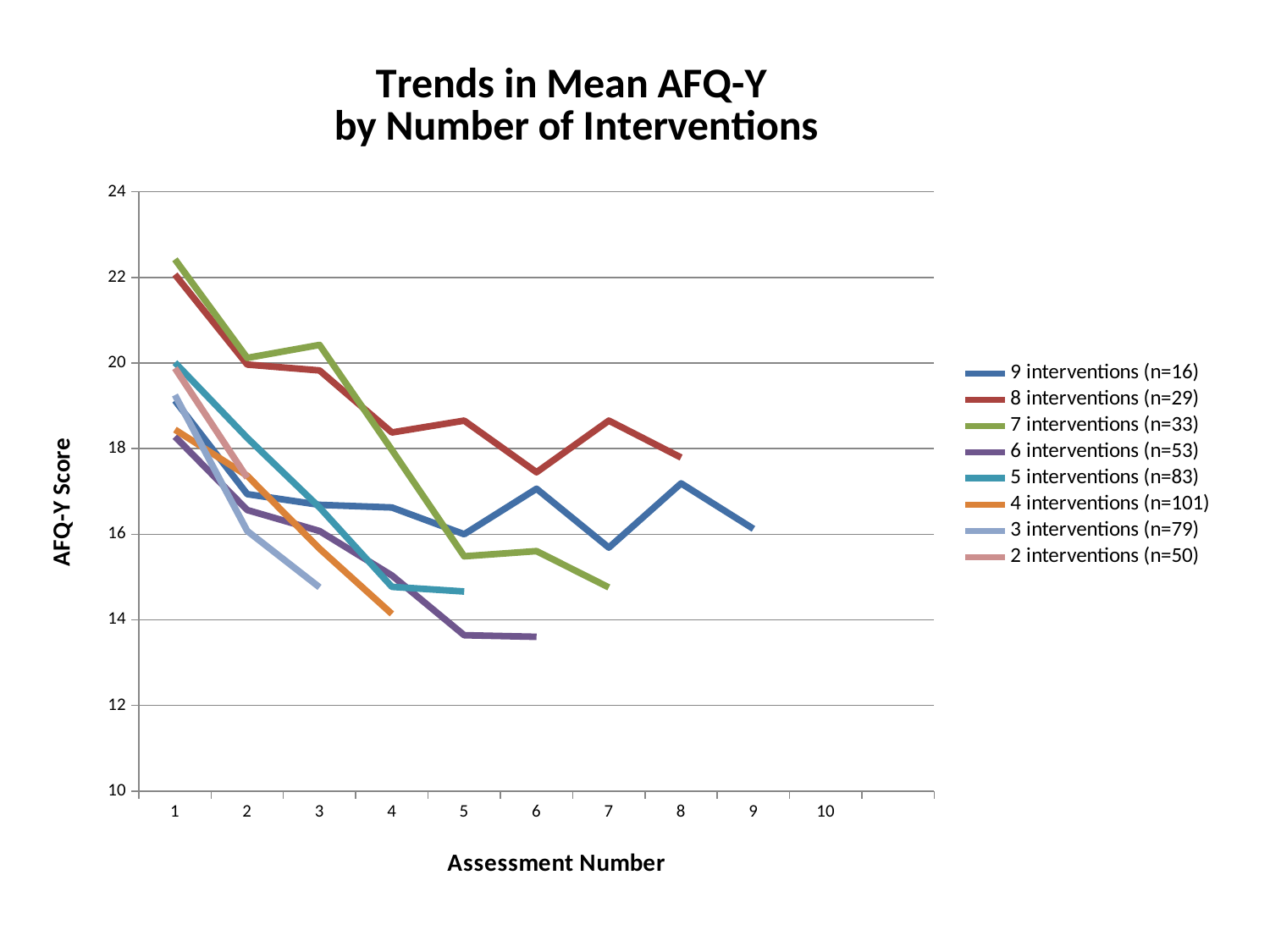
What kind of chart is shown on the slide? line chart Is the value for 7 interventions (n=33) at assessment 1 greater or less than 22? greater How many series does the legend list? 8 What is the label of the vertical axis? AFQ-Y Score Which series reaches the lowest AFQ-Y score on the chart? 6 interventions (n=53) Is the value for 5 interventions (n=83) at assessment 5 greater or less than 14? greater Is the value for 3 interventions (n=79) at assessment 3 greater or less than 14? greater Does the 7 interventions (n=33) series generally rise or fall from assessment 1 to assessment 7? fall At assessment 1, which is higher: 7 interventions (n=33) or 6 interventions (n=53)? 7 interventions (n=33) What is the title of the chart? Trends in Mean AFQ-Y by Number of Interventions